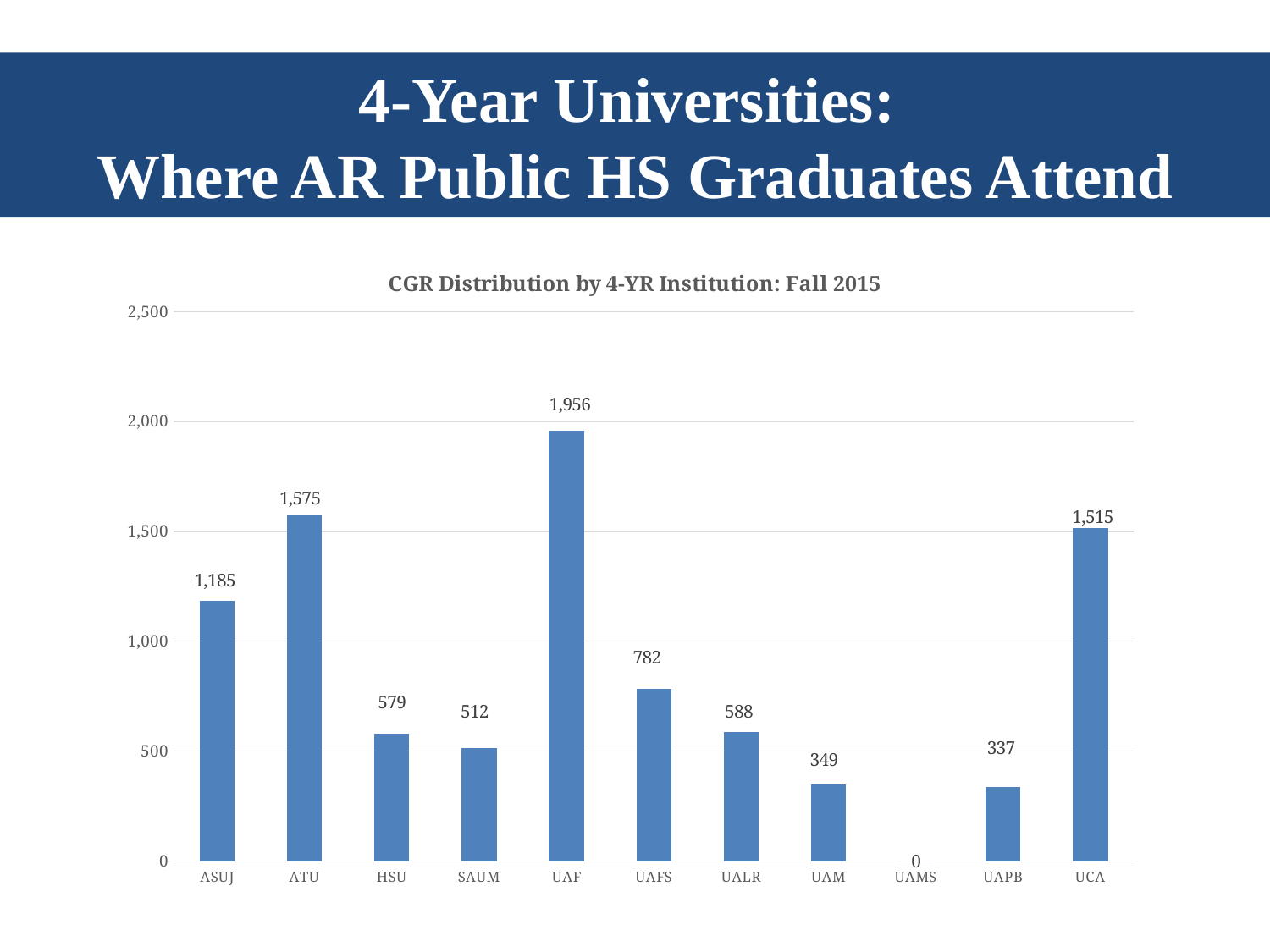
What is the value for UAPB? 337 How many institutions are shown on the x axis? 11 Is the value for UAFS greater or less than 1,000? less What is the title of the chart? CGR Distribution by 4-YR Institution: Fall 2015 What kind of chart is this? bar chart What is the difference between the values for UAF and ASUJ? 771 What is the value for UAF? 1,956 What is the value for UCA? 1,515 Which has a larger value, HSU or UALR? UALR What is the difference between the values for ATU and UCA? 60 Which institution has the lowest value? UAMS Which institution has the highest value? UAF